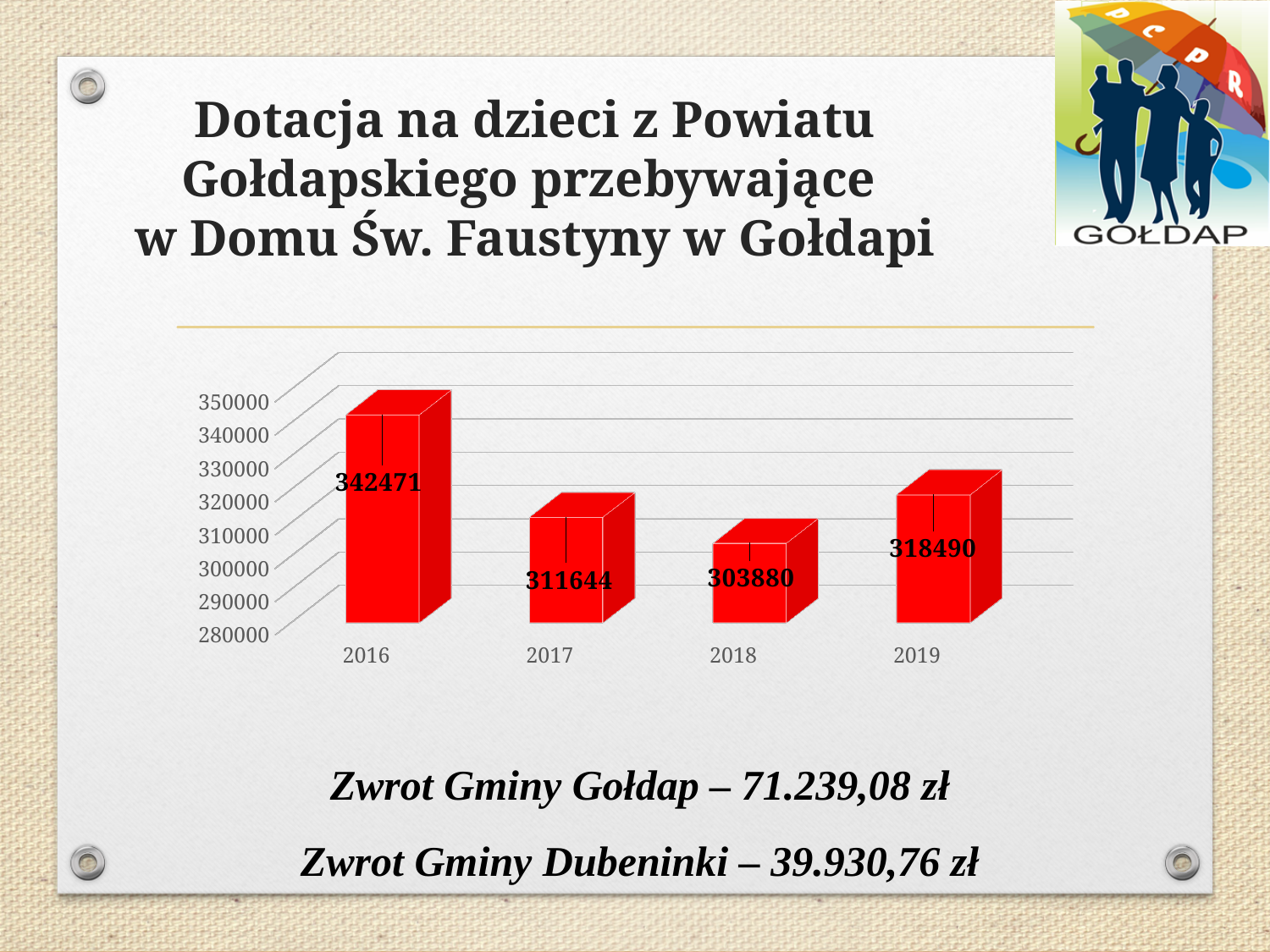
Which year has the highest value? 2016 What is the difference between the values for 2016 and 2017? 30827 What is the value for 2016? 342471 Which year has the lowest value? 2018 What is the value for 2018? 303880 Do the values rise or fall from 2016 to 2018? fall Which is larger, the value for 2017 or the value for 2019? 2019 What kind of chart is shown on the slide? bar chart How many years are shown on the x axis? 4 What is the difference between the values for 2019 and 2018? 14610 What is the value for 2019? 318490 What is the value for 2017? 311644